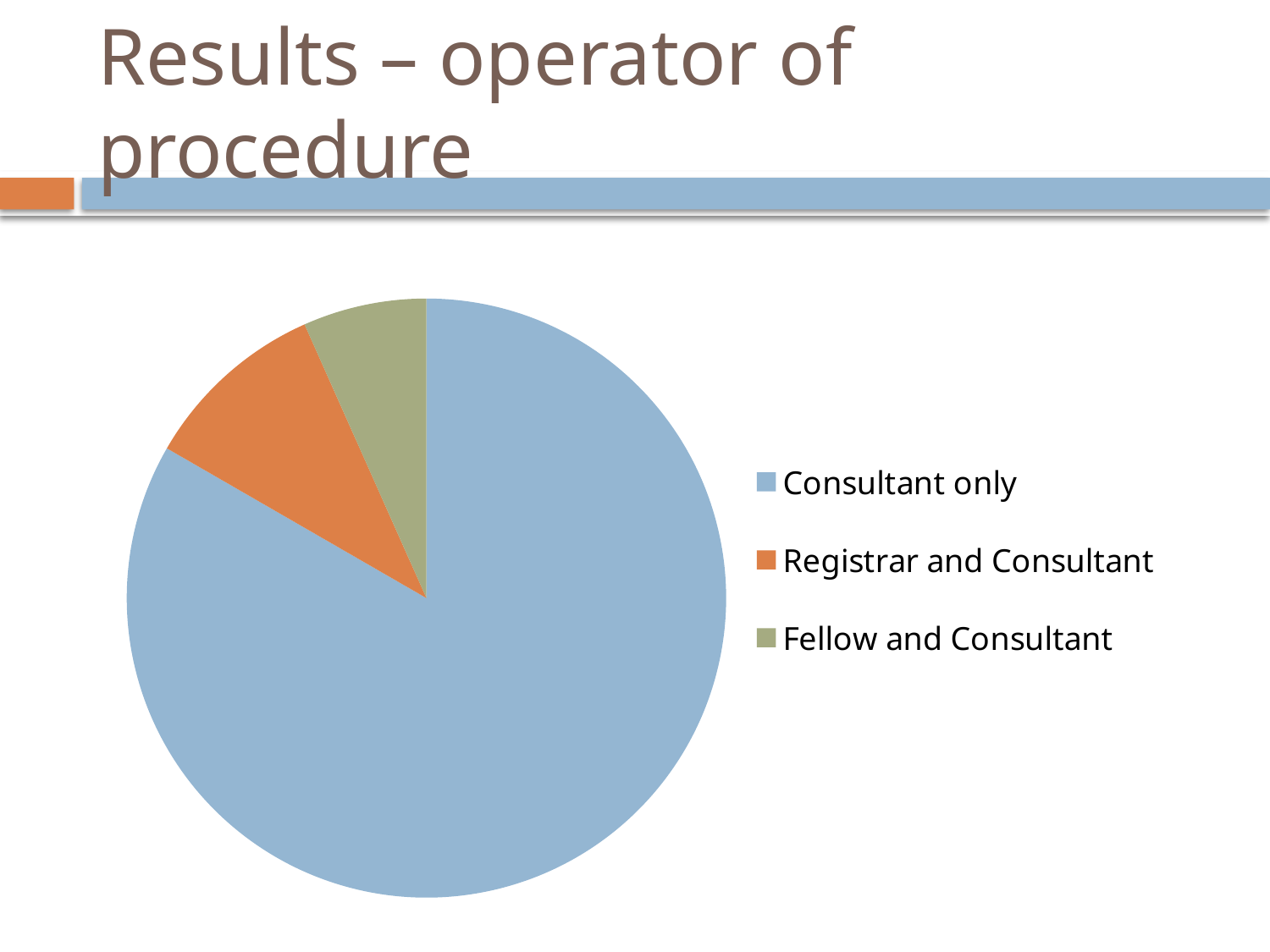
Does the Consultant only slice make up more or less than half of the pie chart? More What kind of chart is shown on the slide? Pie chart Which category has the largest slice of the pie chart? Consultant only Which slice is larger: Registrar and Consultant or Fellow and Consultant? Registrar and Consultant How many entries does the legend of the pie chart list? 3 What is the title of the slide containing the pie chart? Results – operator of procedure Which category has the smallest slice of the pie chart? Fellow and Consultant How many slices does the pie chart have? 3 What colour is the Registrar and Consultant slice in the pie chart? Orange Which slice is larger: Consultant only or Registrar and Consultant? Consultant only